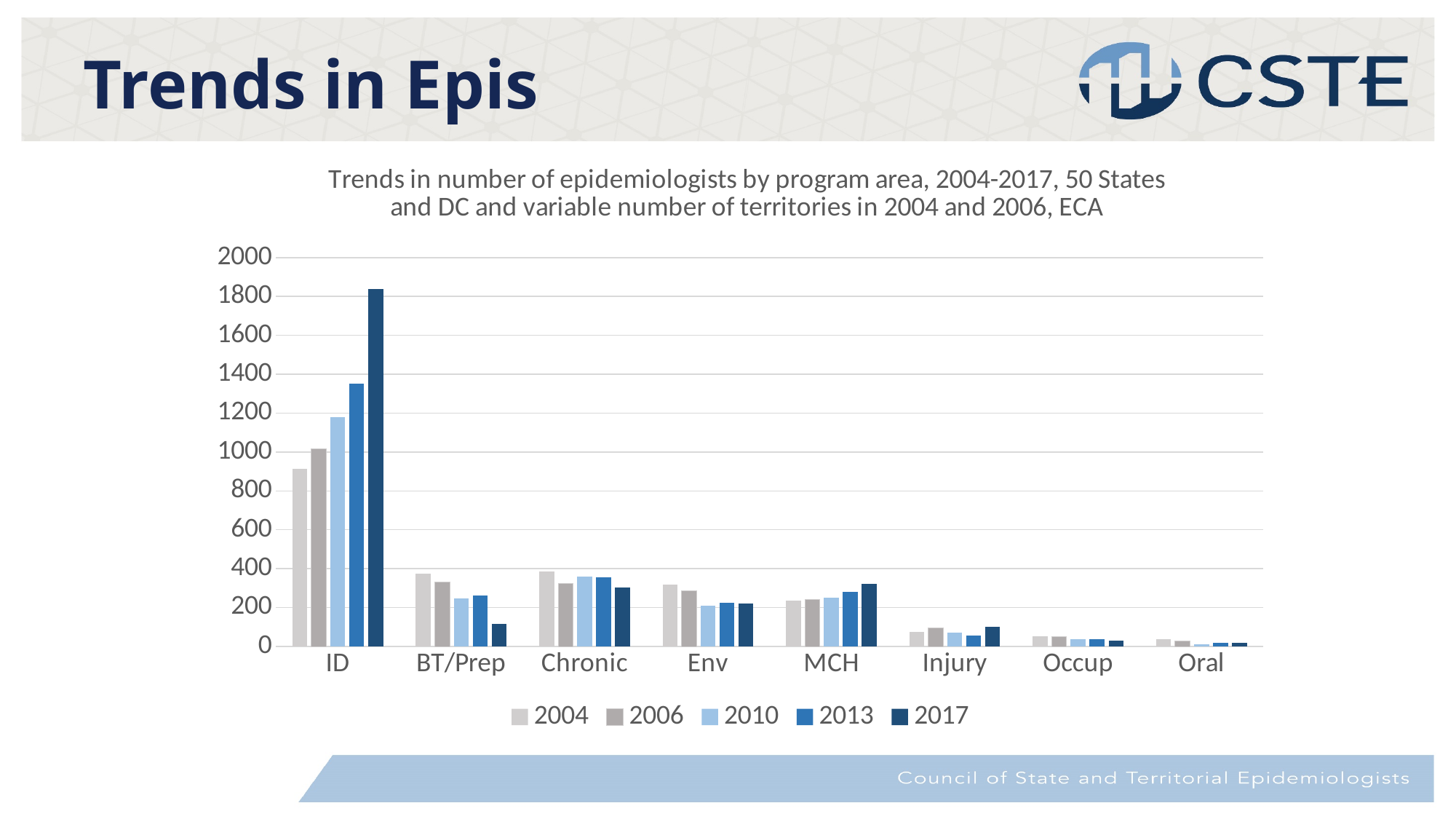
How many series does the legend list? 5 Is the value for BT/Prep in 2017 greater or less than 200? less Is the value for ID in 2017 greater or less than 1600? greater Which program area has the highest number of epidemiologists in 2017? ID Which years are listed in the chart legend? 2004, 2006, 2010, 2013, 2017 For MCH, which year has more epidemiologists, 2004 or 2017? 2017 How many program areas are shown along the x axis? 8 In 2004, which has more epidemiologists, Chronic or Env? Chronic Which program area has the lowest number of epidemiologists in 2017? Oral What kind of chart is shown on the slide? bar chart Do the values for ID rise or fall from 2004 to 2017? rise Do the values for BT/Prep rise or fall from 2004 to 2017? fall